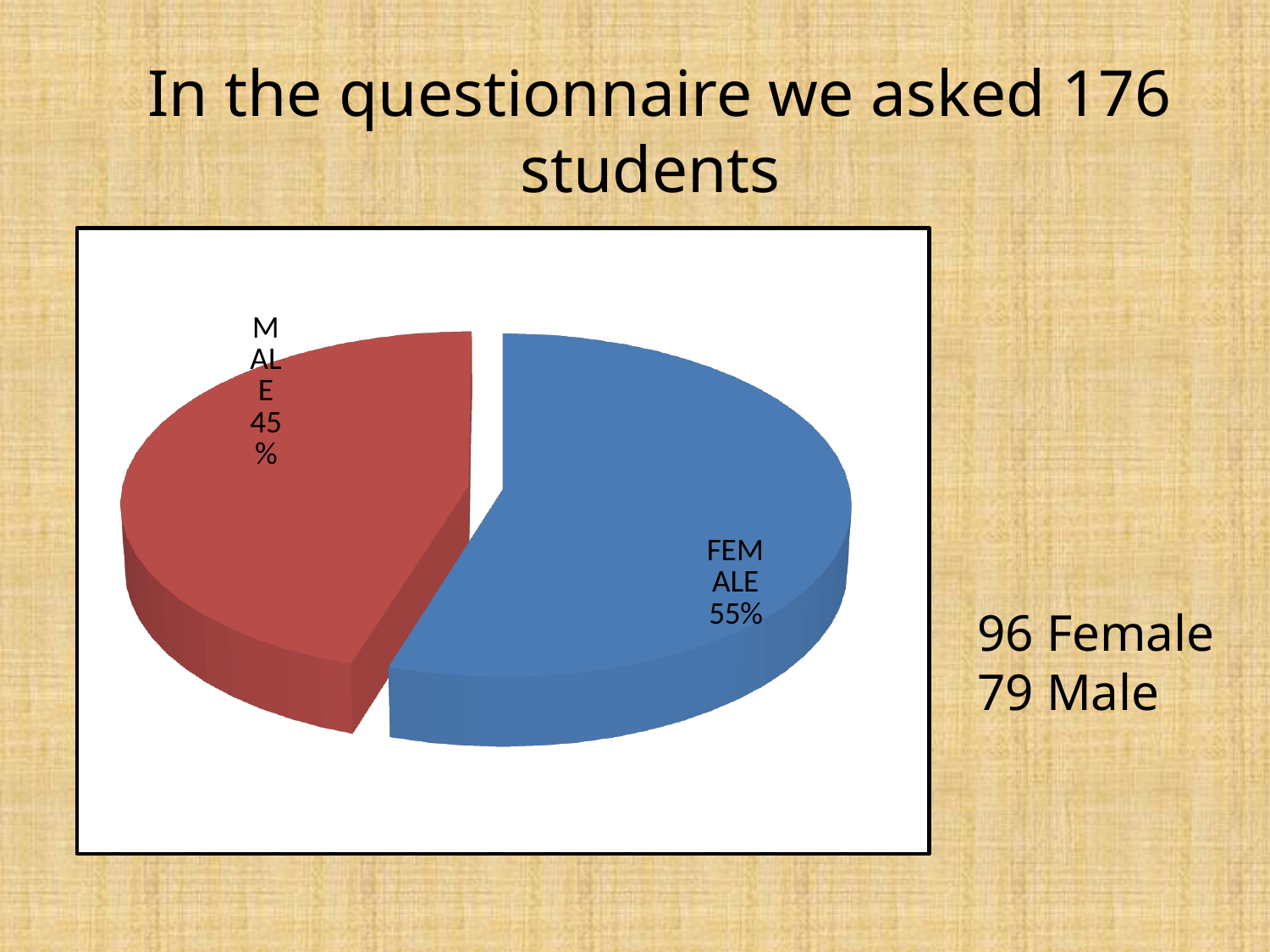
Which slice of the pie is the largest? FEMALE How many slices does the pie chart have? 2 What colour is the FEMALE slice? blue What is the difference in percentage points between the FEMALE and MALE slices? 10 Is the FEMALE slice greater or less than 50% of the pie? greater Which slice is larger, FEMALE or MALE? FEMALE What percentage of the pie is labelled FEMALE? 55% What percentage of the pie is labelled MALE? 45% What colour is the MALE slice? red Which slice of the pie is the smallest? MALE What kind of chart is shown on the slide? pie chart What is the share of the pie taken by the MALE slice? 45%